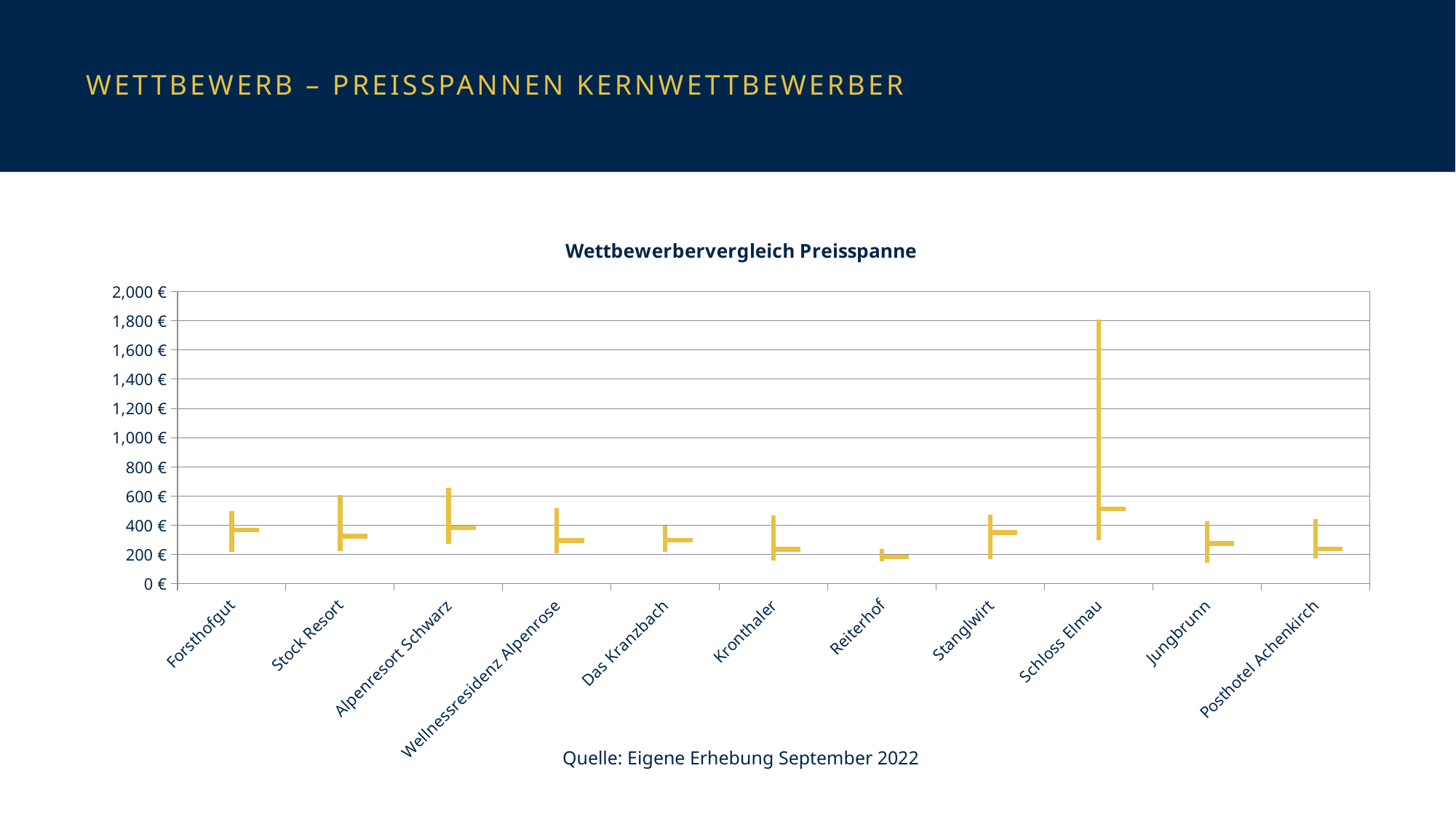
Which competitor has the lowest upper price value in the chart? Reiterhof Is the upper price value for Das Kranzbach greater or less than 600 €? less Is the upper price value for Schloss Elmau greater or less than 1,600 €? greater What is the highest value shown on the y axis of the chart? 2,000 € Which has the higher upper price value, Schloss Elmau or Forsthofgut? Schloss Elmau How many competitors (categories) are shown on the x axis of the chart? 11 Is the upper price value for Alpenresort Schwarz greater or less than 400 €? greater What is the title of the chart? Wettbewerbervergleich Preisspanne What kind of chart is shown on the slide? High-low (stock) chart Which competitor has the highest upper price value in the chart? Schloss Elmau Which has the higher upper price value, Alpenresort Schwarz or Das Kranzbach? Alpenresort Schwarz